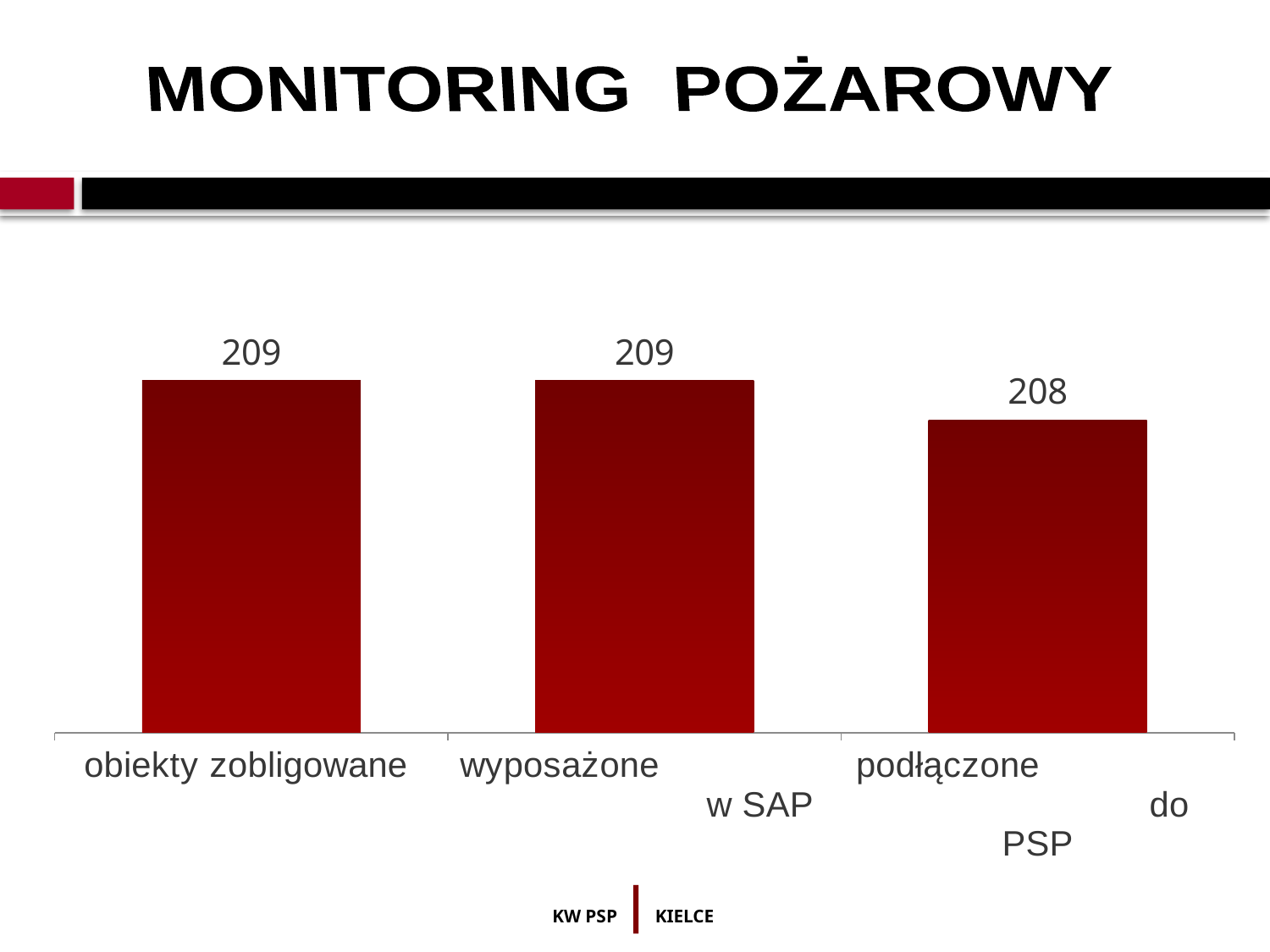
Do 'obiekty zobligowane' and 'wyposażone w SAP' have the same value? Yes What is the difference between the values for 'wyposażone w SAP' and 'podłączone do PSP'? 1 Which category has the lowest value? podłączone do PSP How many categories are shown in the chart? 3 What is the value for 'podłączone do PSP'? 208 What colour are the bars in the chart? Dark red Which is larger, the value for 'wyposażone w SAP' or the value for 'podłączone do PSP'? wyposażone w SAP What is the title of the slide? MONITORING POŻAROWY What is the value for 'wyposażone w SAP'? 209 What is the difference between the values for 'obiekty zobligowane' and 'podłączone do PSP'? 1 What kind of chart is shown on the slide? Bar chart What is the value for 'obiekty zobligowane'? 209